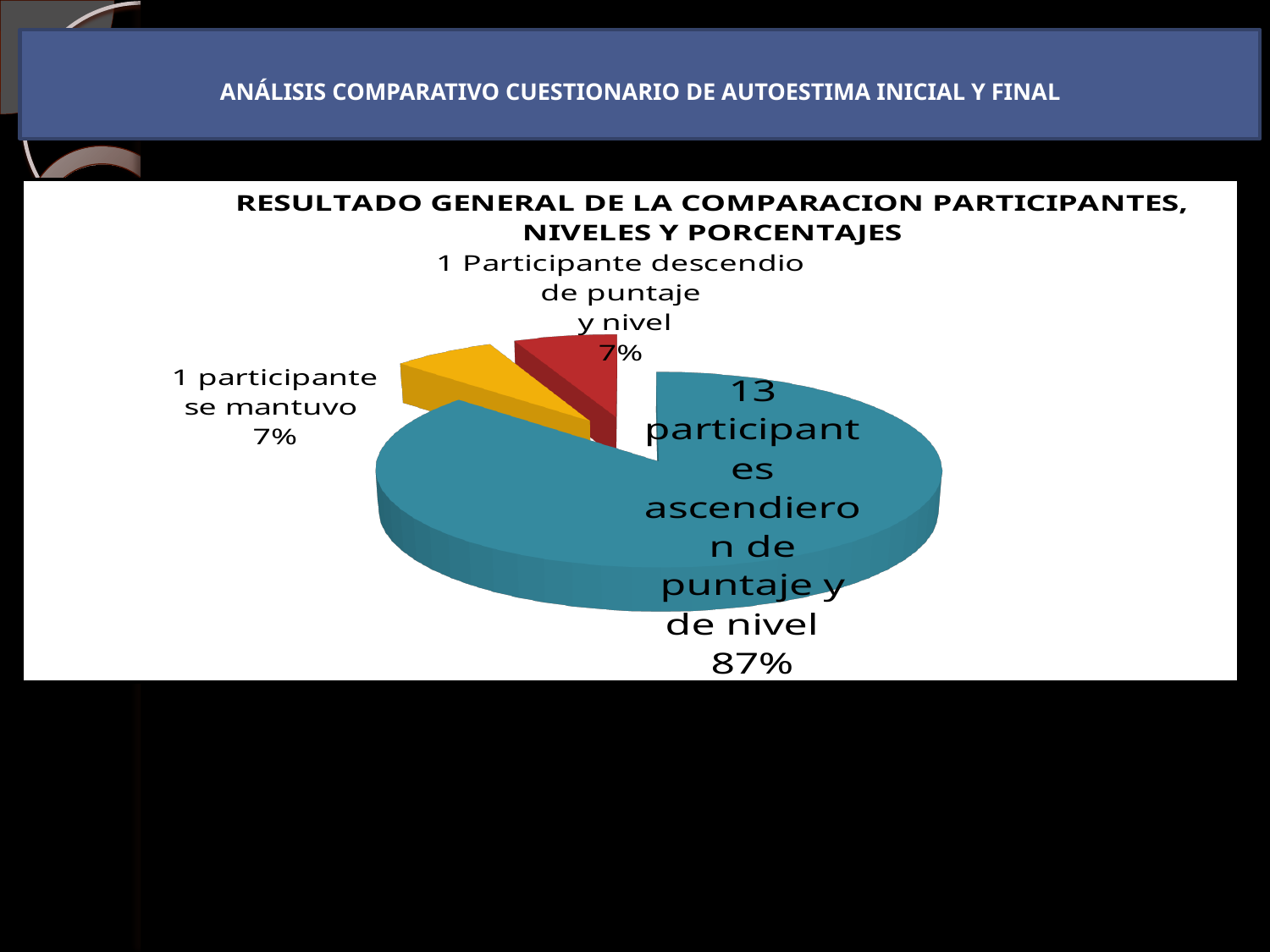
What percentage of the pie corresponds to the participant who descended in score and level (descendio de puntaje y nivel)? 7% Which slice of the pie is the largest? 13 participantes ascendieron de puntaje y de nivel What is the title of the chart? RESULTADO GENERAL DE LA COMPARACION PARTICIPANTES, NIVELES Y PORCENTAJES What kind of chart is shown on the slide? Pie chart Which is larger: the share for participants who ascended or the share for the participant who descended? Participants who ascended What percentage of the pie corresponds to the participants who ascended in score and level (ascendieron de puntaje y de nivel)? 87% What percentage of the pie corresponds to the participant who stayed the same (se mantuvo)? 7% How many slices does the pie chart have? 3 What is the difference in percentage points between the slice for participants who ascended and the slice for the participant who stayed the same? 80 How many participants stayed the same (se mantuvo) according to the chart? 1 What colour is the slice for the 13 participants who ascended in score and level? Teal (blue-green) How many participants ascended in score and level according to the chart? 13